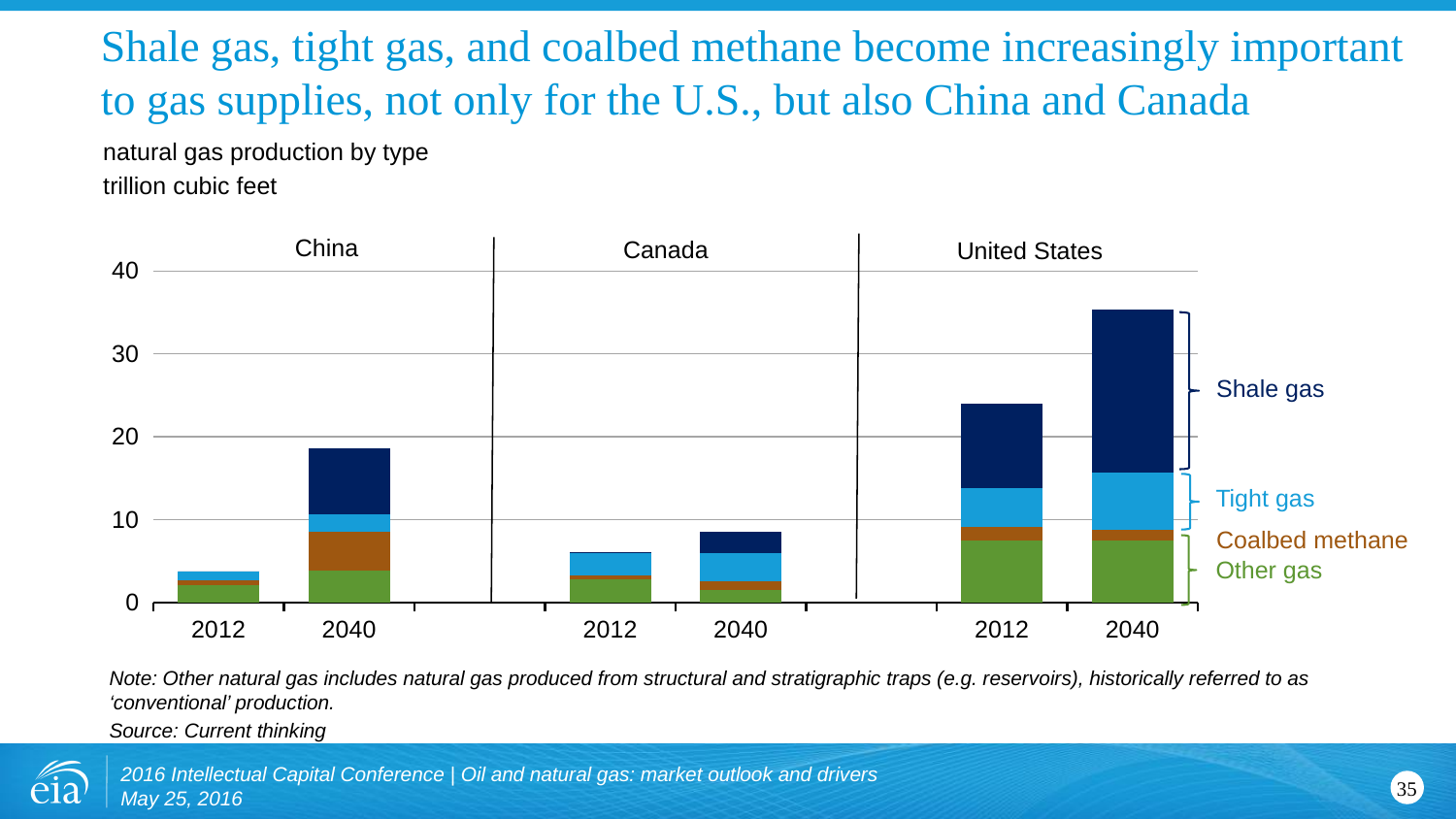
What unit of measurement is used for the chart's values? trillion cubic feet Which country and year has the lowest total natural gas production on the chart? China 2012 Is the total production for Canada in 2040 greater or less than 10 trillion cubic feet? less Is the total production for China in 2040 greater or less than 20 trillion cubic feet? less How many stacked bars are plotted on the chart? 6 Is the total production for the United States in 2040 greater or less than 30 trillion cubic feet? greater Which country and year has the highest total natural gas production on the chart? United States 2040 How many gas types (series) does the chart's legend list? 4 Does China's total natural gas production rise or fall from 2012 to 2040? rise Which is larger: total production for the United States in 2012 or for China in 2040? United States 2012 What kind of chart is shown on the slide? bar chart